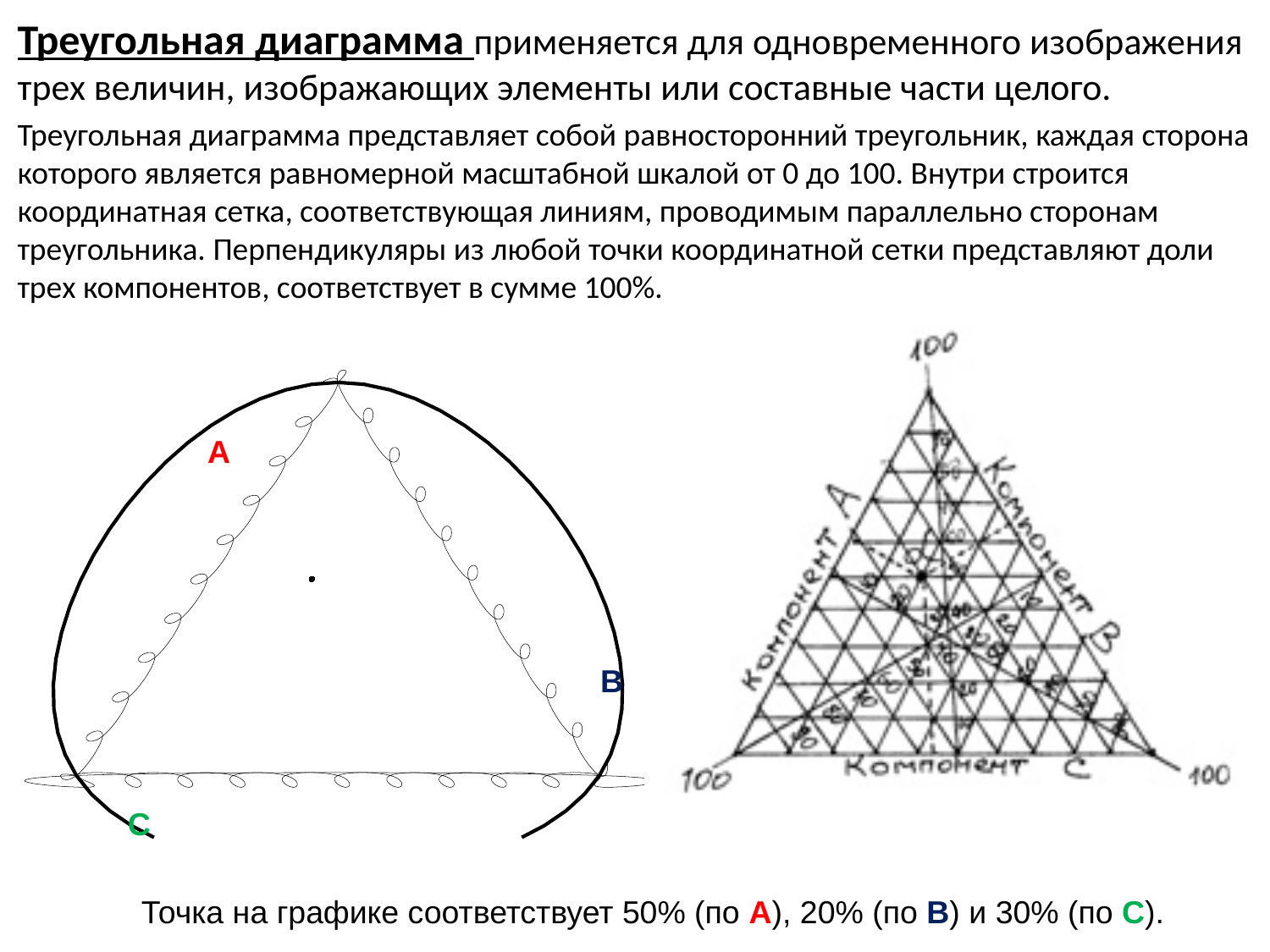
Which is larger for the plotted point, the share of component C or the share of component B? C On the right-hand diagram, what value is marked at each corner of the triangle? 100 According to the caption, what share does the plotted point have for component B? 20% What is the sum of the three component shares for the plotted point? 100% According to the caption, what share does the plotted point have for component C? 30% How many components does the triangular diagram represent simultaneously? 3 According to the caption, what share does the plotted point have for component A? 50% What is the difference between the shares of component A and component B for the plotted point? 30% What kind of chart is shown on the slide? Треугольная диаграмма (triangular diagram) Which component has the smallest share for the plotted point? B On the right-hand diagram, which component is labelled along the bottom side of the triangle? Компонент C Which component has the largest share for the plotted point? A